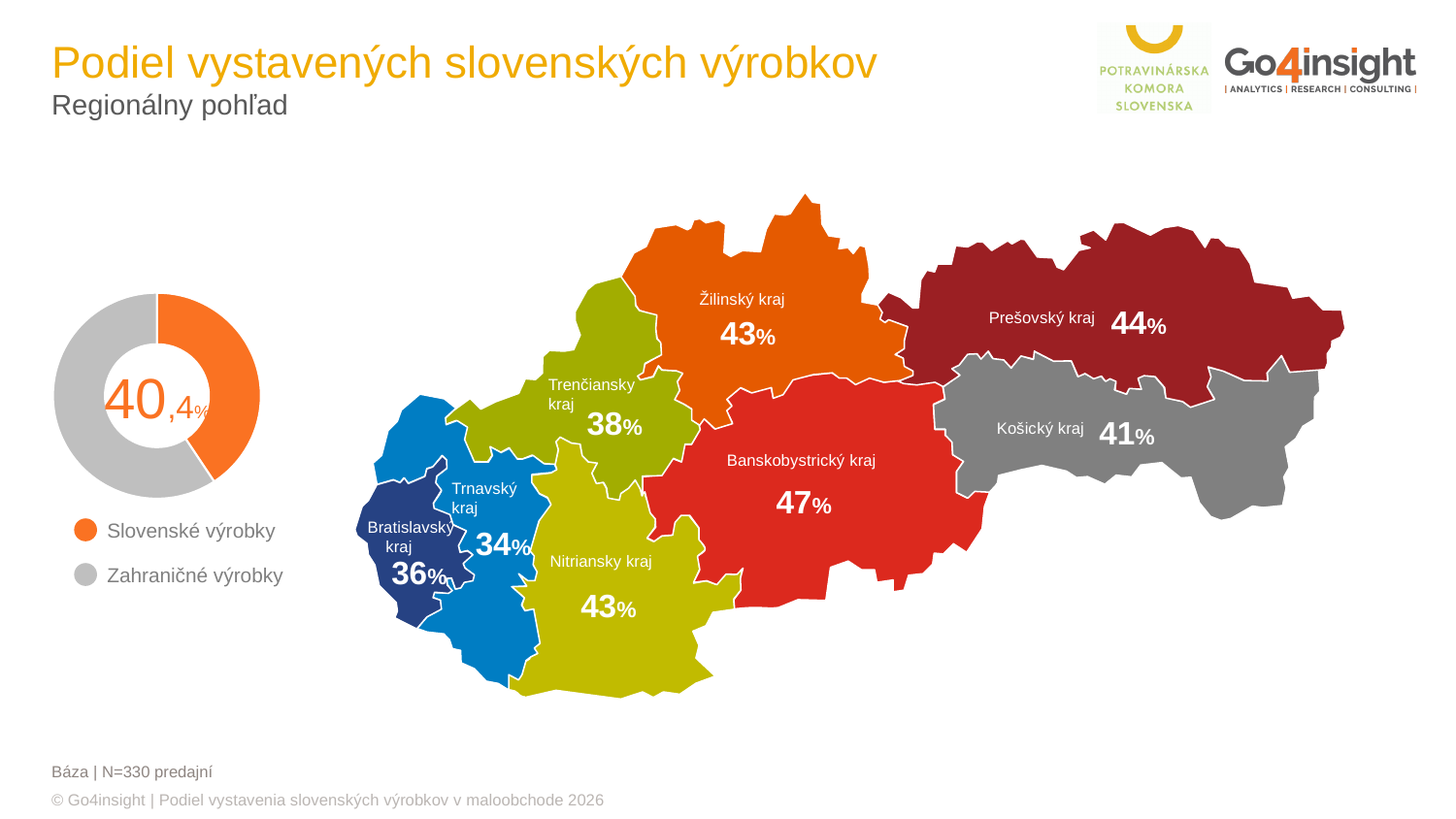
On the map, what value is shown for Košický kraj? 41% On the donut chart, what colour represents Slovenské výrobky? Orange On the donut chart on the left, what share is shown for Slovenské výrobky? 40,4% How many entries does the legend of the donut chart list? 2 What kind of chart is shown on the left of the slide? Donut (pie) chart On the map, what value is shown for Banskobystrický kraj? 47% How many regions with values are shown on the map? 8 On the map, which region has the highest value? Banskobystrický kraj On the map, what value is shown for Trnavský kraj? 34% On the map, which region has the lowest value? Trnavský kraj On the donut chart, which segment is larger: Slovenské výrobky or Zahraničné výrobky? Zahraničné výrobky On the map, what is the difference between the values for Banskobystrický kraj and Trnavský kraj? 13 percentage points